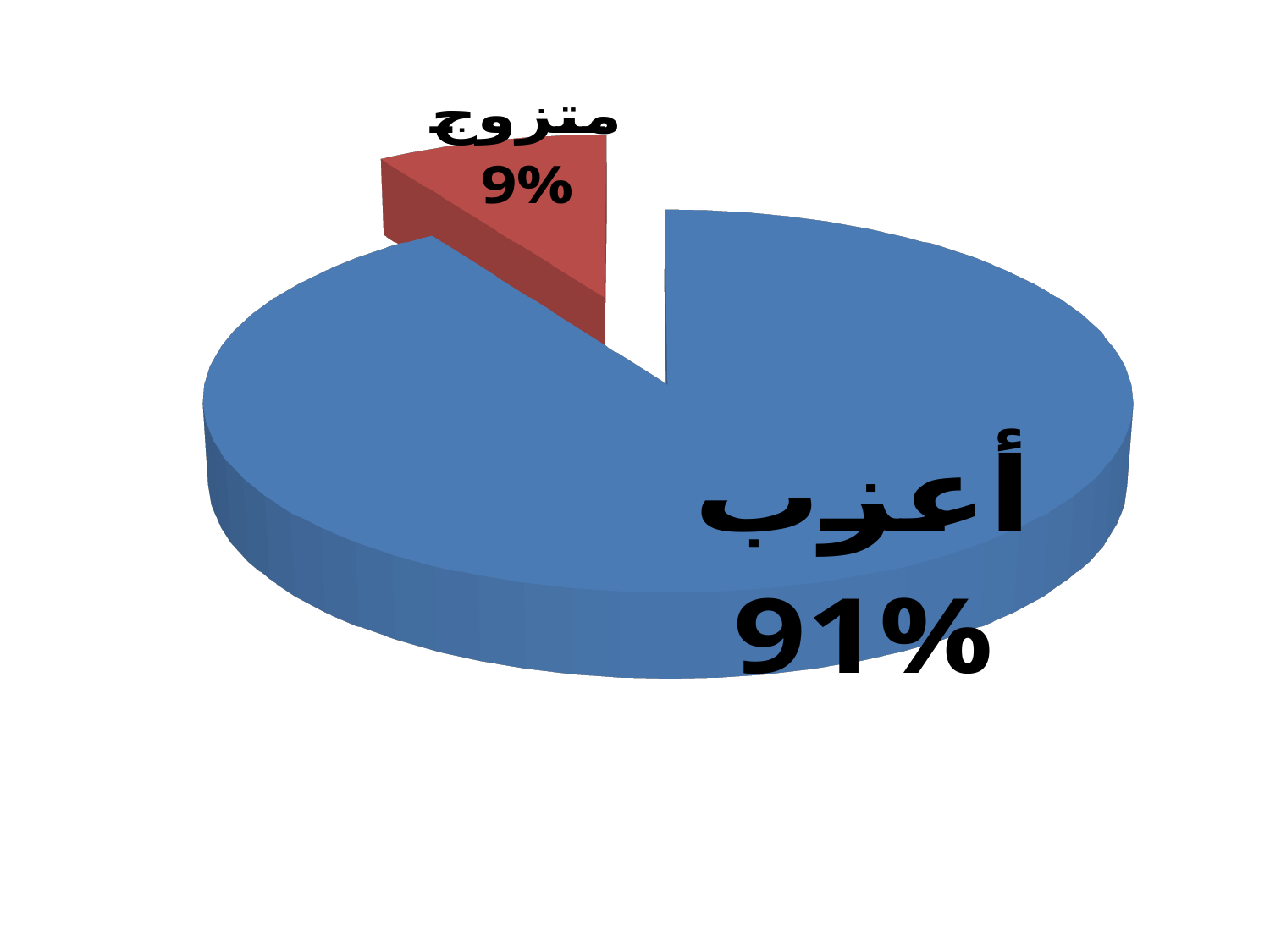
Which slice is the smallest in the pie chart? متزوج Which is larger, the "أعزب" slice or the "متزوج" slice? أعزب What colour is the "أعزب" slice? blue What is the difference in percentage points between the "أعزب" slice and the "متزوج" slice? 82 Which slice is the largest in the pie chart? أعزب How many slices does the pie chart have? 2 What percentage is shown for the "متزوج" slice? 9% What share of the pie does the "متزوج" slice represent? 9% What colour is the "متزوج" slice? red What percentage is shown for the "أعزب" slice? 91% What kind of chart is shown on the slide? pie chart